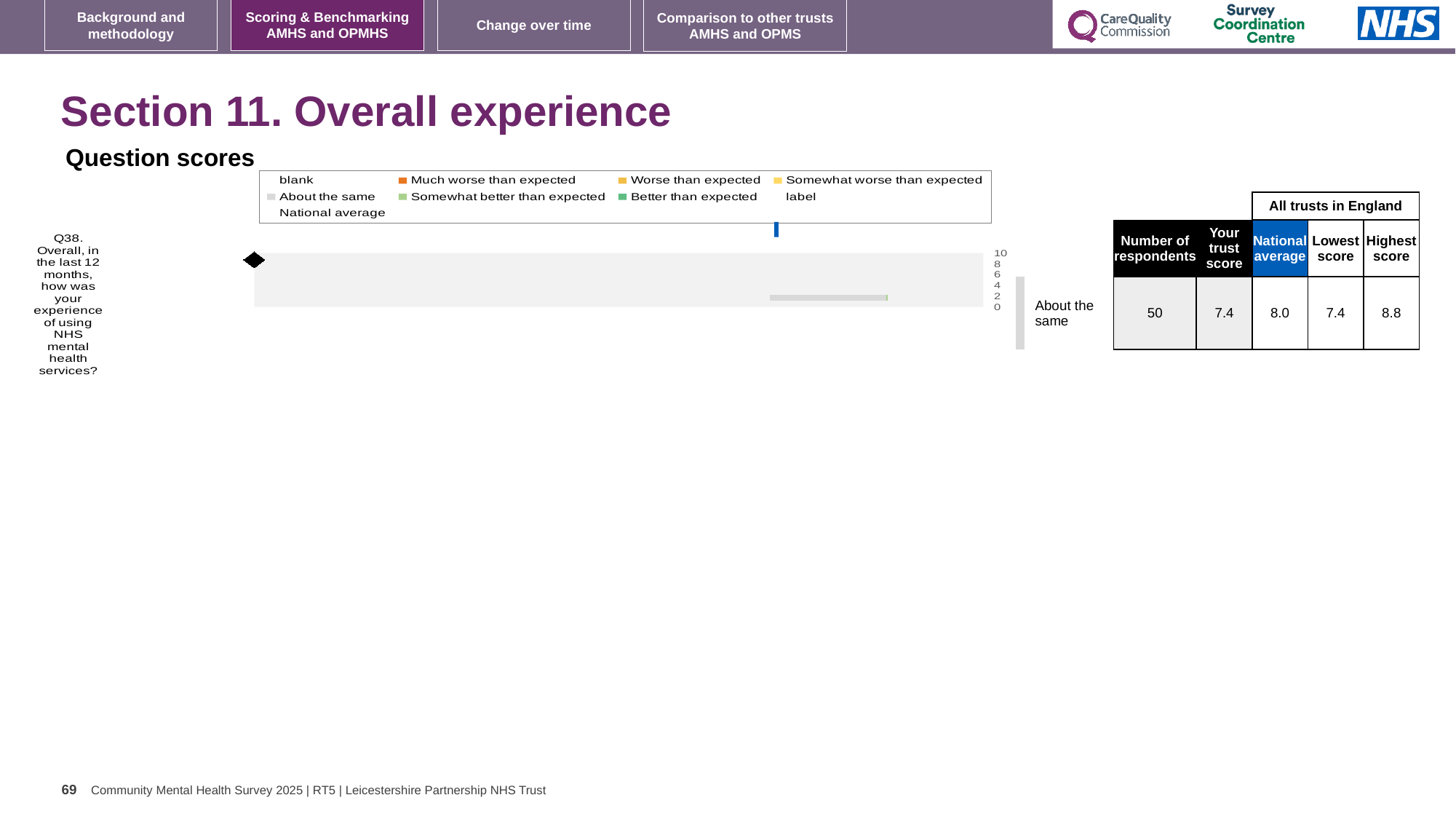
How many questions are plotted in the Question scores chart? 1 Which is larger for Q38: the trust's score or the national average? the national average What is the highest value shown on the score axis of the Question scores chart? 10 In the table beside the chart, how many respondents answered Q38? 50 In the table beside the chart, what is the trust's score for Q38? 7.4 What kind of chart is used to show the Q38 question score? bar chart In the table beside the chart, what is the lowest score among all trusts in England for Q38? 7.4 Which question is plotted in the Question scores chart? Q38. Overall, in the last 12 months, how was your experience of using NHS mental health services? Which benchmark category is shown next to the Q38 bar in the Question scores chart? About the same In the table beside the chart, what is the national average score for Q38? 8.0 What is the difference between the national average (8.0) and the trust's score (7.4) for Q38? 0.6 In the table beside the chart, what is the highest score among all trusts in England for Q38? 8.8